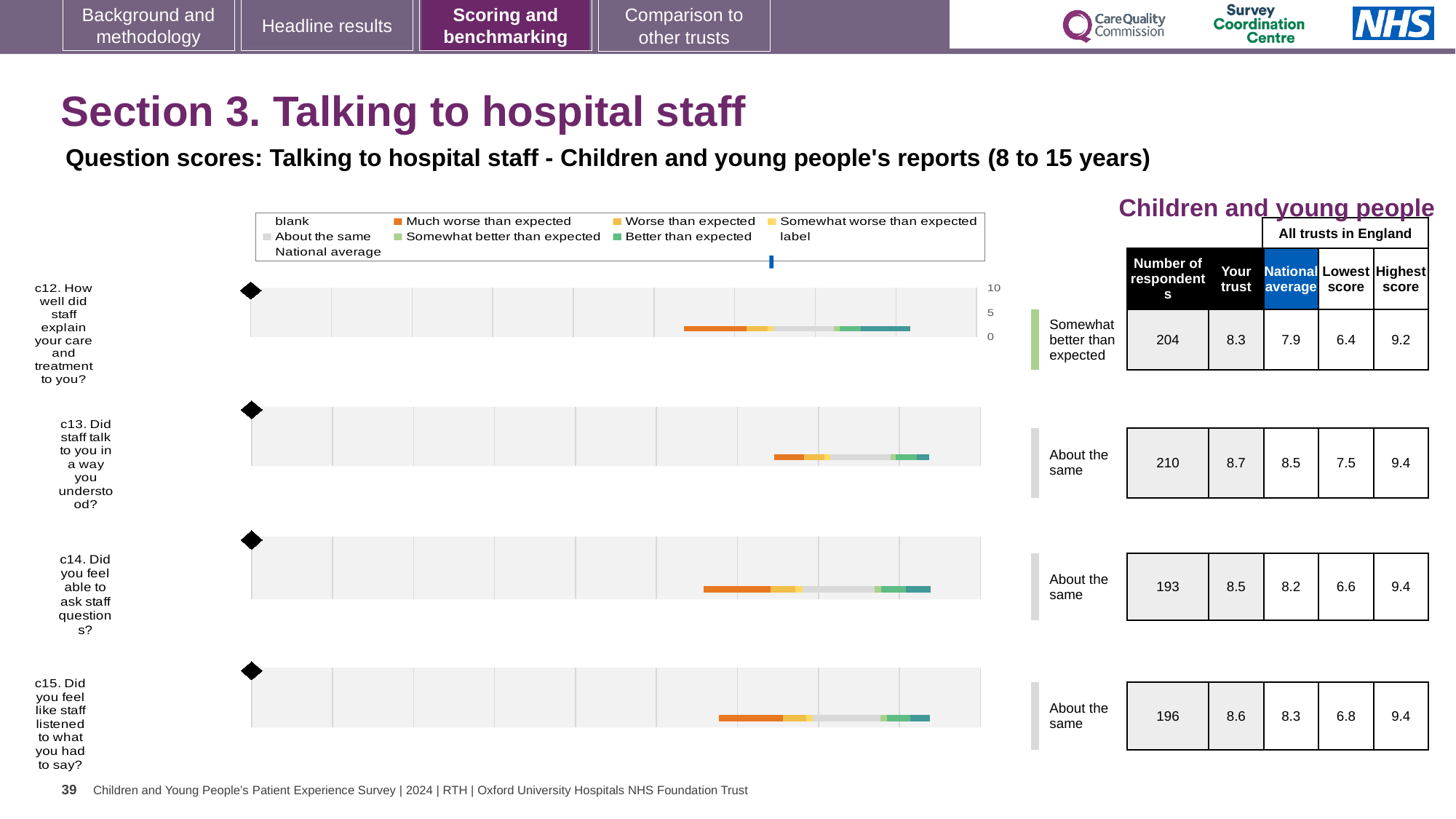
What benchmark category is shown next to the bar for c12? Somewhat better than expected What kind of chart is used to show the question scores for c12 to c15? bar chart According to the table, what is the lowest score across all trusts in England for c12 (How well did staff explain your care and treatment to you?)? 6.4 What is the title of the chart on the slide? Question scores: Talking to hospital staff - Children and young people's reports (8 to 15 years) According to the table, how many respondents answered c14 (Did you feel able to ask staff questions?)? 193 According to the table, what is the national average for c15 (Did you feel like staff listened to what you had to say?)? 8.3 For c14, which is larger: the 'Your trust' score or the national average? Your trust Which question has the fewest respondents in the table? c14 Which question has the highest 'Your trust' score in the table? c13 According to the table, what is the 'Your trust' score for c13 (Did staff talk to you in a way you understood?)? 8.7 What is the difference between the 'Your trust' score and the national average for c12? 0.4 How many questions (categories) are plotted in the chart? 4